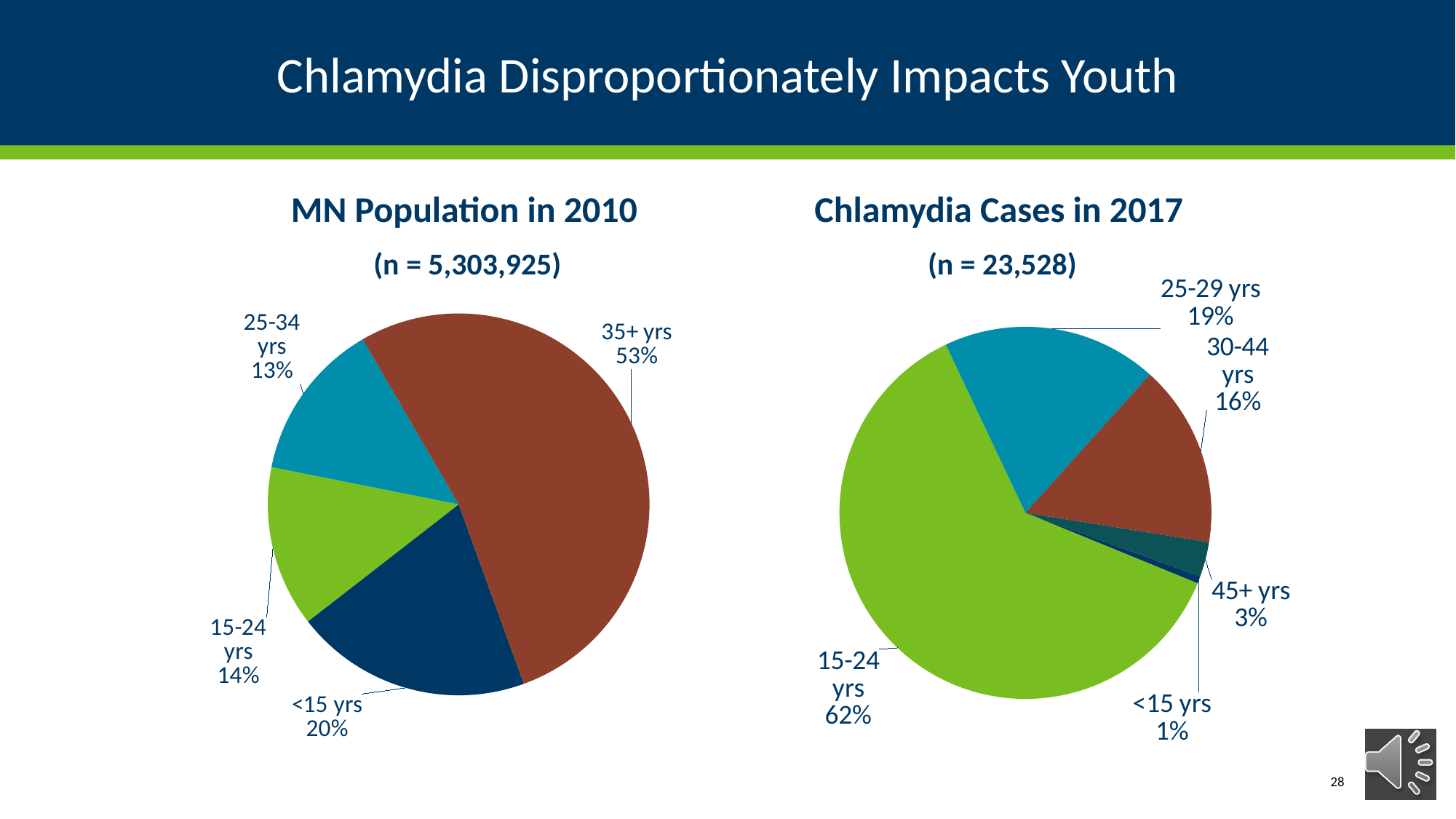
How many slices does the 'Chlamydia Cases in 2017' pie chart have? 5 In the 'MN Population in 2010' pie chart, what share of the population is 35+ yrs? 53% In the 'Chlamydia Cases in 2017' pie chart, which age group has the smallest share? <15 yrs In the 'MN Population in 2010' pie chart, which age group has the largest share? 35+ yrs What type of chart is used for 'MN Population in 2010'? Pie chart What is the sample size (n) shown for the 'Chlamydia Cases in 2017' chart? 23,528 In the 'MN Population in 2010' pie chart, what share is 15-24 yrs? 14% In the 'MN Population in 2010' pie chart, which age group has the smallest share? 25-34 yrs In the 'Chlamydia Cases in 2017' pie chart, what share of cases is 15-24 yrs? 62% In the 'MN Population in 2010' pie chart, which is larger: the <15 yrs share or the 15-24 yrs share? <15 yrs In the 'Chlamydia Cases in 2017' pie chart, what is the difference between the 25-29 yrs share and the 30-44 yrs share? 3% In the 'Chlamydia Cases in 2017' pie chart, what share is 45+ yrs? 3%